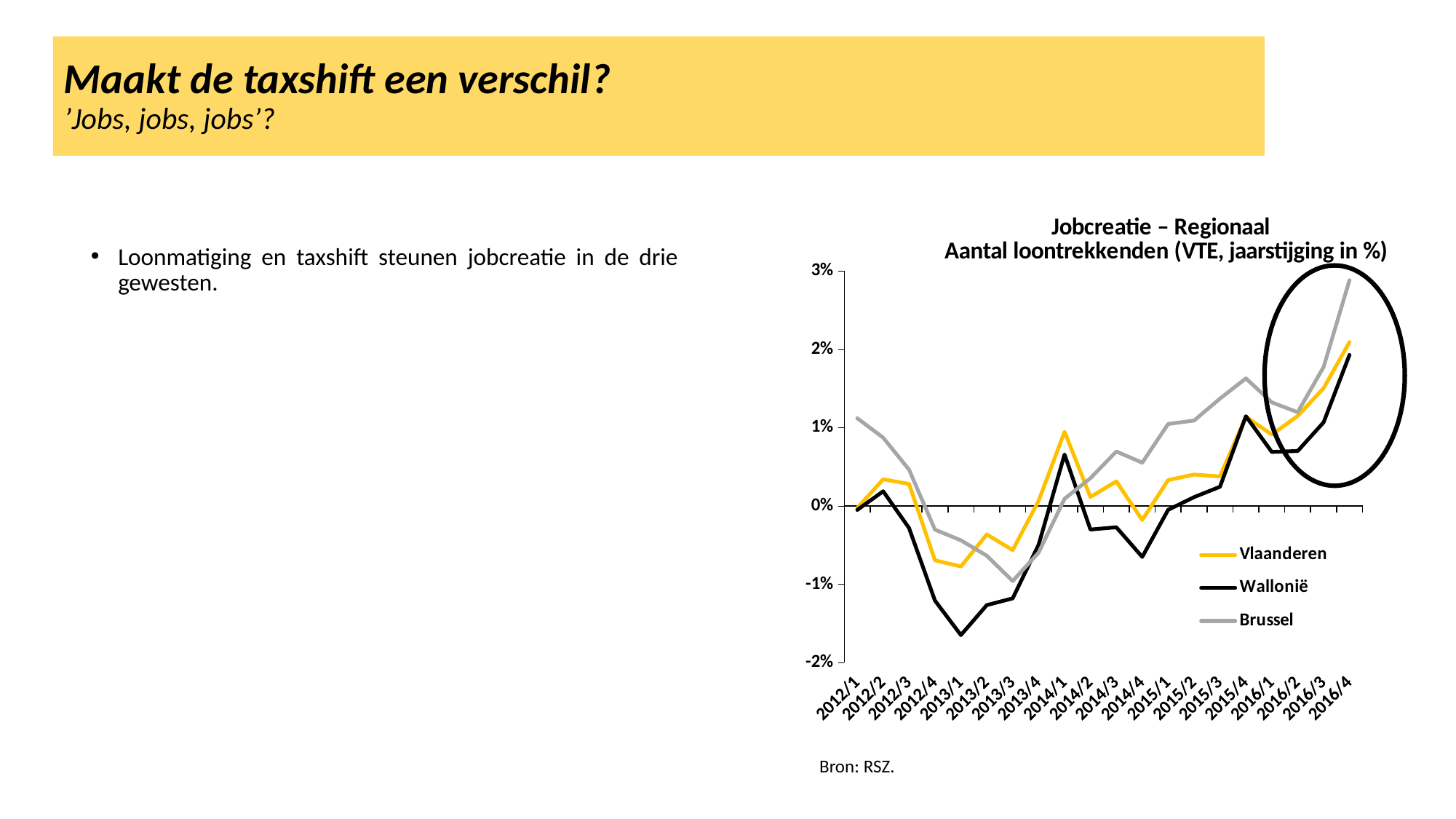
Which series is drawn in yellow in the chart? Vlaanderen Does the Brussel line rise or fall from 2016/1 to 2016/4? Rise Is the value for Brussel at 2016/4 greater or less than 2%? greater Is the value for Vlaanderen at 2016/4 greater or less than 1%? greater Is the value for Wallonië at 2013/1 greater or less than -1%? less Which series has the highest value at 2016/4? Brussel How many quarters are shown along the x axis of the chart? 20 Which series has the lowest value at 2013/1? Wallonië What kind of chart is shown on the slide? Line chart How many series does the legend of the chart list? 3 At 2012/1, which series has the larger value, Brussel or Vlaanderen? Brussel